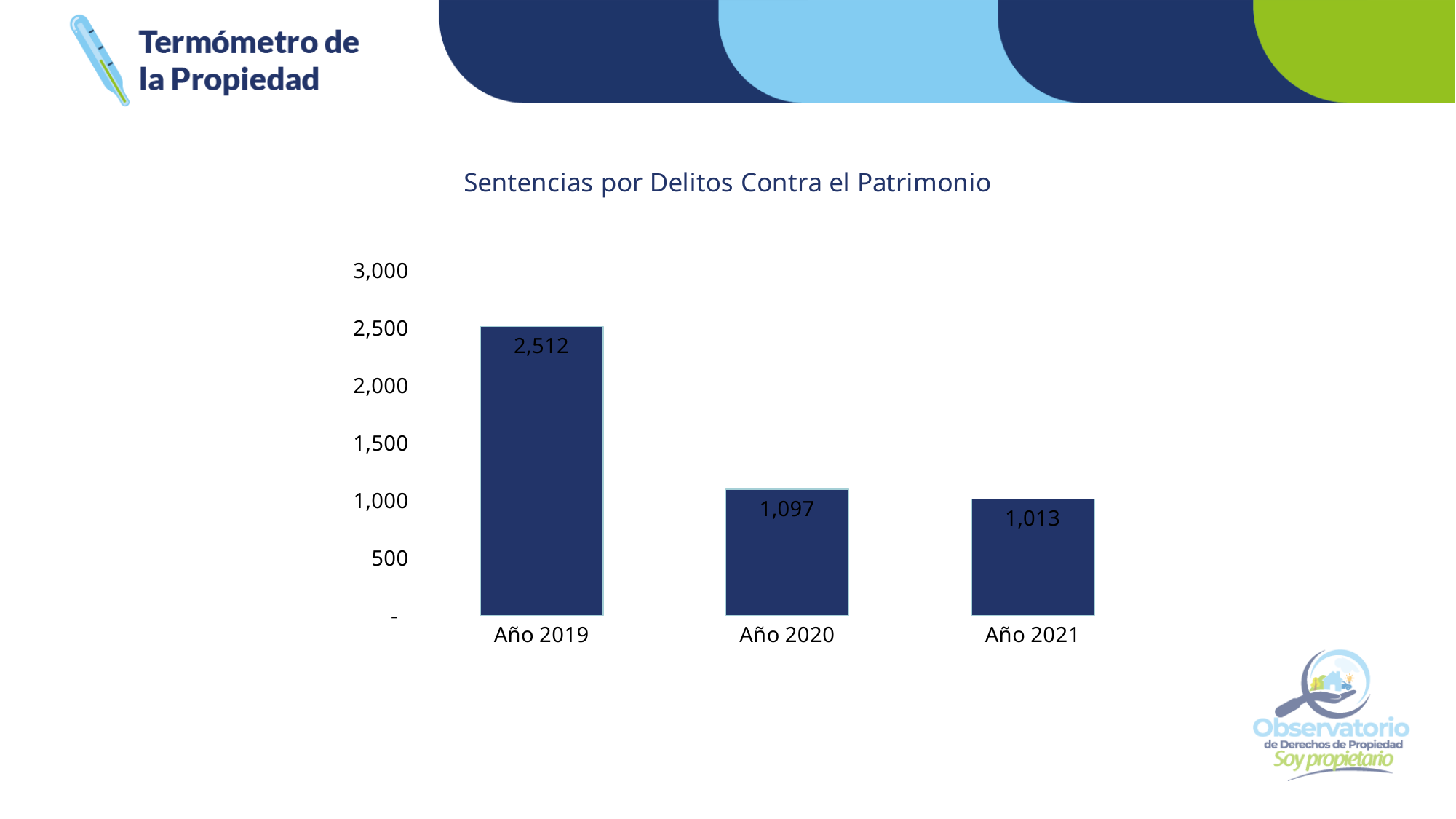
What is the difference between the values for Año 2020 and Año 2021? 84 What kind of chart is shown on the slide? bar chart Which year has the lowest value? Año 2021 What is the value for Año 2019? 2,512 What is the value for Año 2021? 1,013 Is the value for Año 2019 greater or less than 2,000? greater How many years are shown on the chart? 3 Which year has the highest value? Año 2019 Which is larger, the value for Año 2019 or the value for Año 2021? Año 2019 What is the difference between the values for Año 2019 and Año 2020? 1,415 What is the value for Año 2020? 1,097 What is the title of the chart? Sentencias por Delitos Contra el Patrimonio